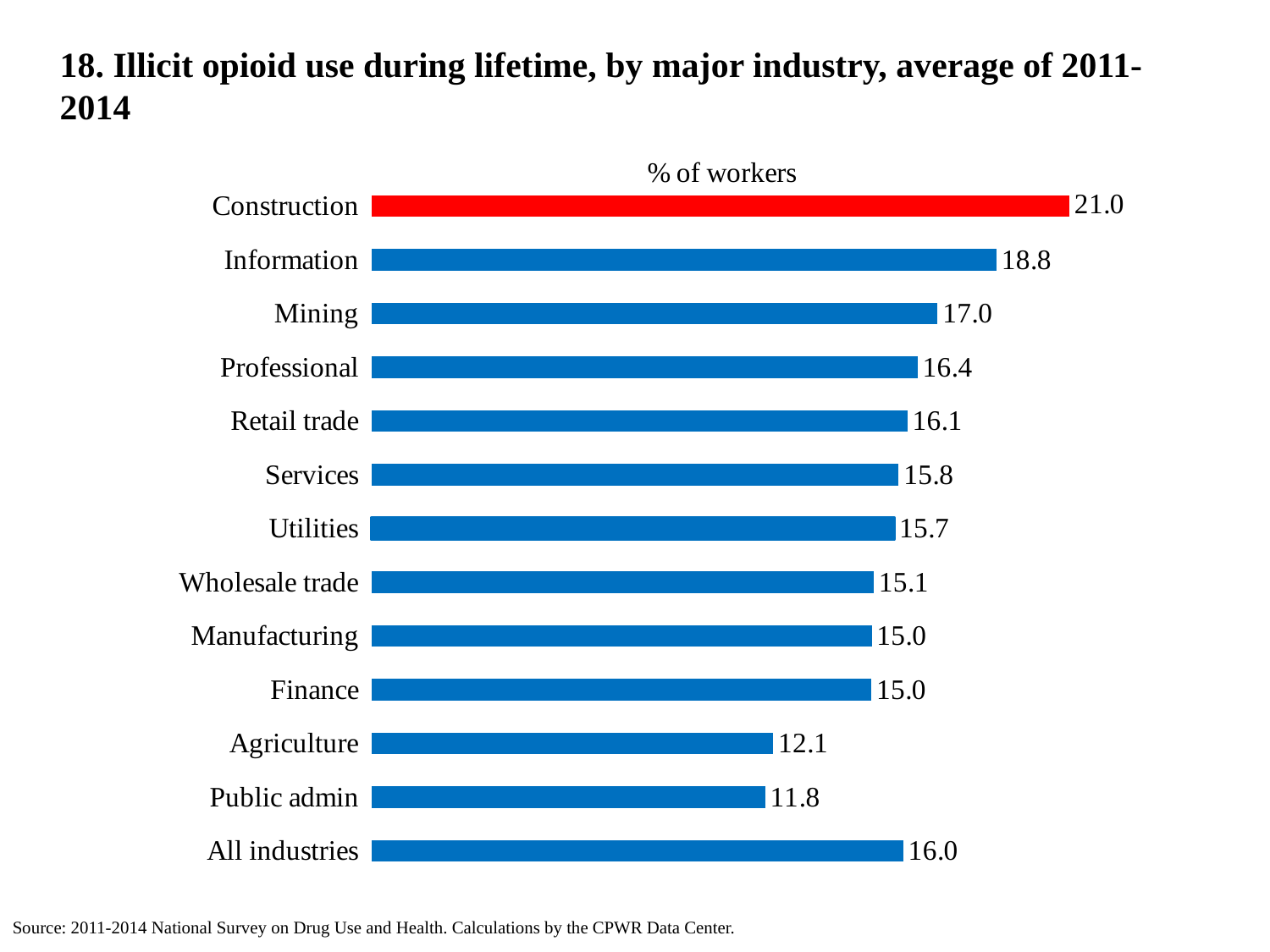
Which is larger, the value for Mining or the value for Agriculture? Mining Which industry has the lowest value? Public admin How many bars are shown in the chart? 13 What is the value for Public admin? 11.8 What is the difference between the values for Construction and Information? 2.2 What is the difference between the values for Construction and All industries? 5.0 What is the label shown above the bars in the chart? % of workers Which industry has the highest value? Construction Which bar is coloured red? Construction What is the value for All industries? 16.0 What kind of chart is this? Bar chart What is the value for Construction? 21.0